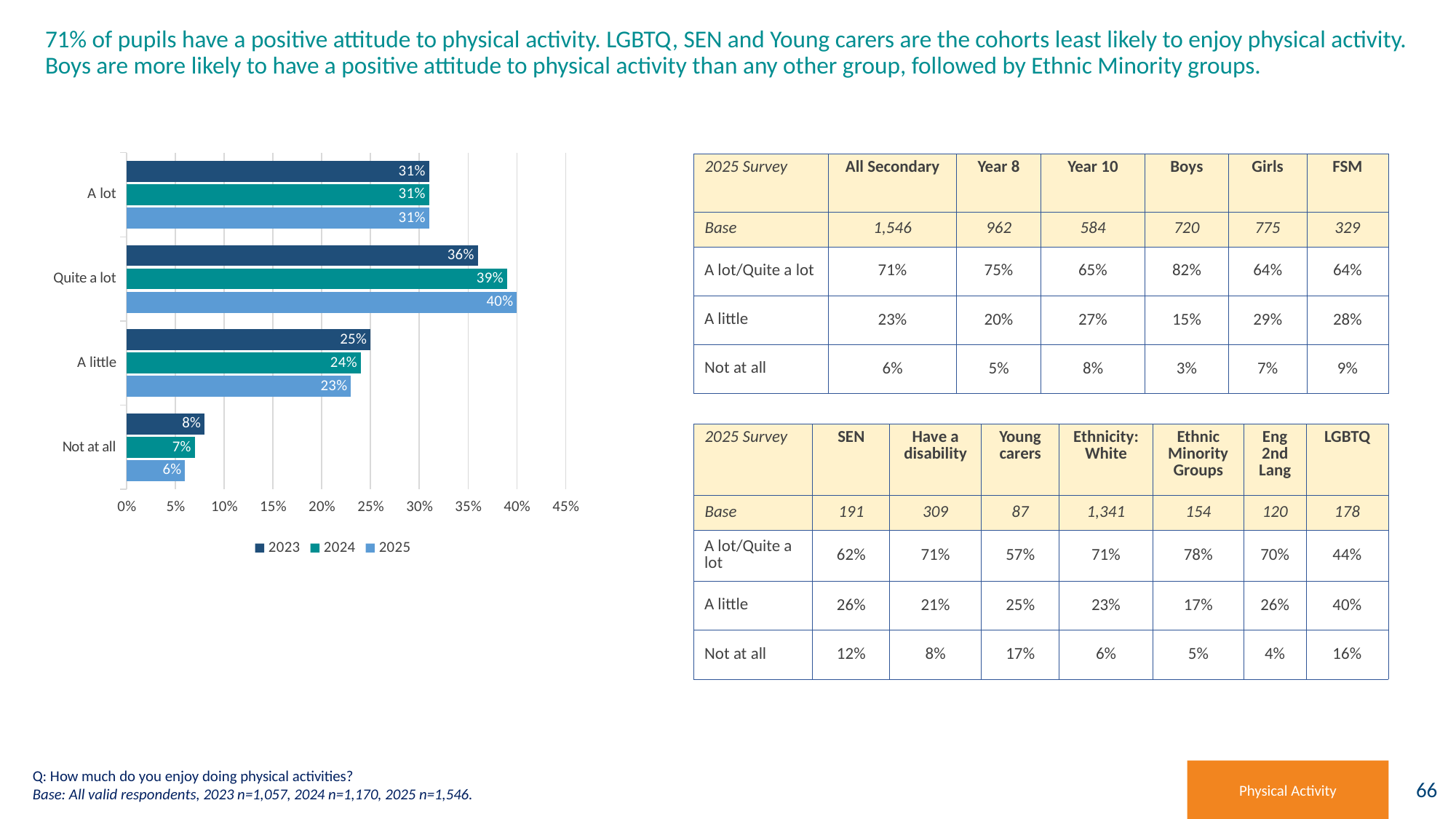
Which is larger for 'A little': the 2023 value or the 2025 value? 2023 What is the 2023 value for 'Not at all'? 8% Which category has the lowest value for the 2023 series? Not at all Does the 'Not at all' value rise or fall from 2023 to 2025? Fall How many categories are shown on the chart? 4 What is the 2025 value for 'Quite a lot'? 40% How many series does the legend list? 3 What kind of chart is shown on the slide? Bar chart Which category has the highest value for the 2025 series? Quite a lot What is the 2024 value for 'A little'? 24% What is the difference between the 2025 and 2023 values for 'Quite a lot'? 4 percentage points What are the series names listed in the chart legend? 2023, 2024, 2025